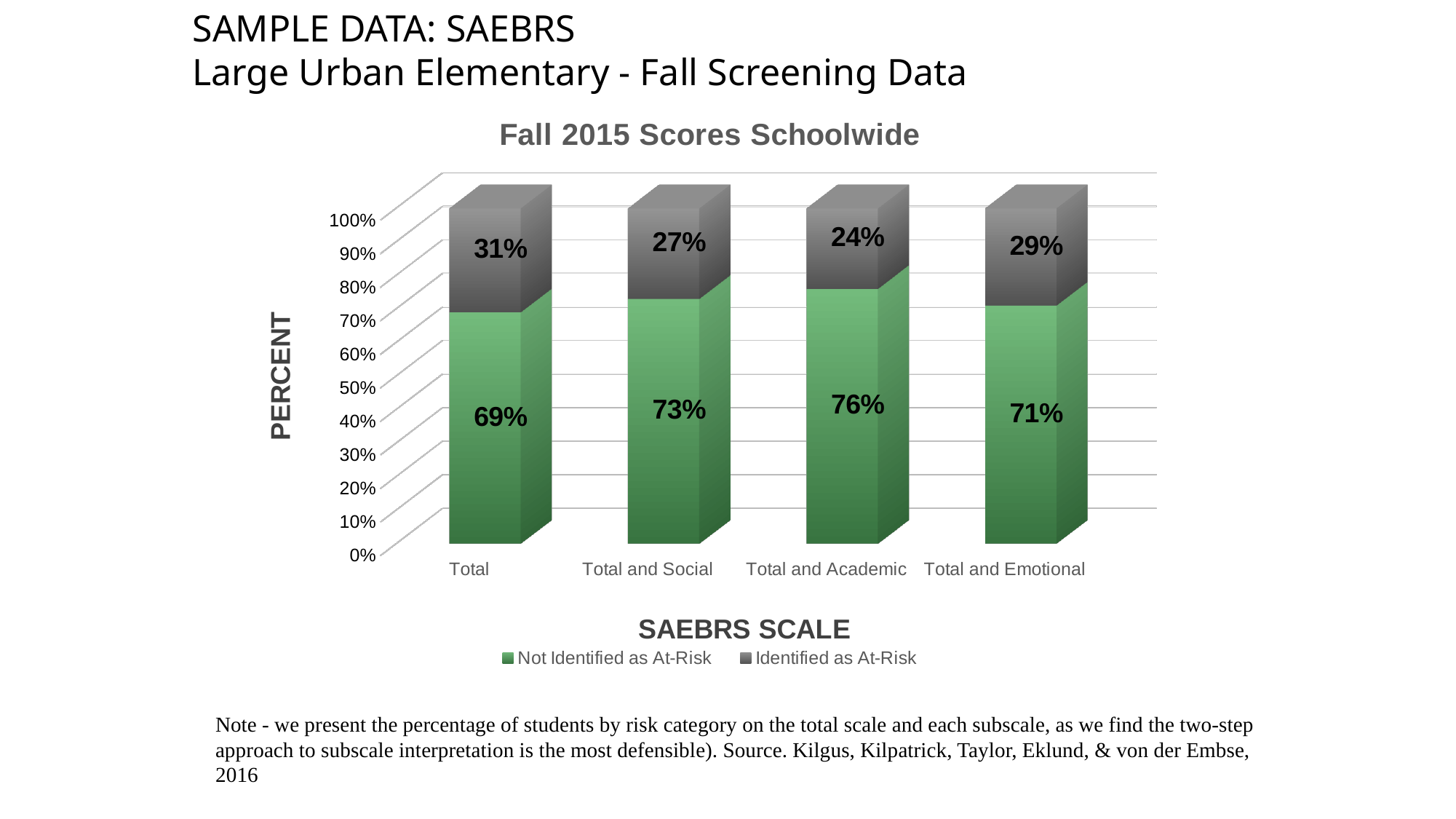
How many series does the legend list? 2 Which SAEBRS scale has the lowest percentage of students Identified as At-Risk? Total and Academic What percentage of students were Identified as At-Risk on the Total and Academic scale? 24% What percentage of students were Not Identified as At-Risk on the Total scale? 69% What kind of chart is shown on the slide? Stacked bar chart What is the difference between the Identified as At-Risk percentages for Total and Total and Social? 4% Which SAEBRS scale has the highest percentage of students Not Identified as At-Risk? Total and Academic Which is larger: the Not Identified as At-Risk percentage for Total and Social or for Total and Emotional? Total and Social What is the title of the chart? Fall 2015 Scores Schoolwide How many SAEBRS scale categories are shown on the x axis? 4 What percentage of students were Identified as At-Risk on the Total and Emotional scale? 29% What is the total of the stacked bar for Total and Social? 100%